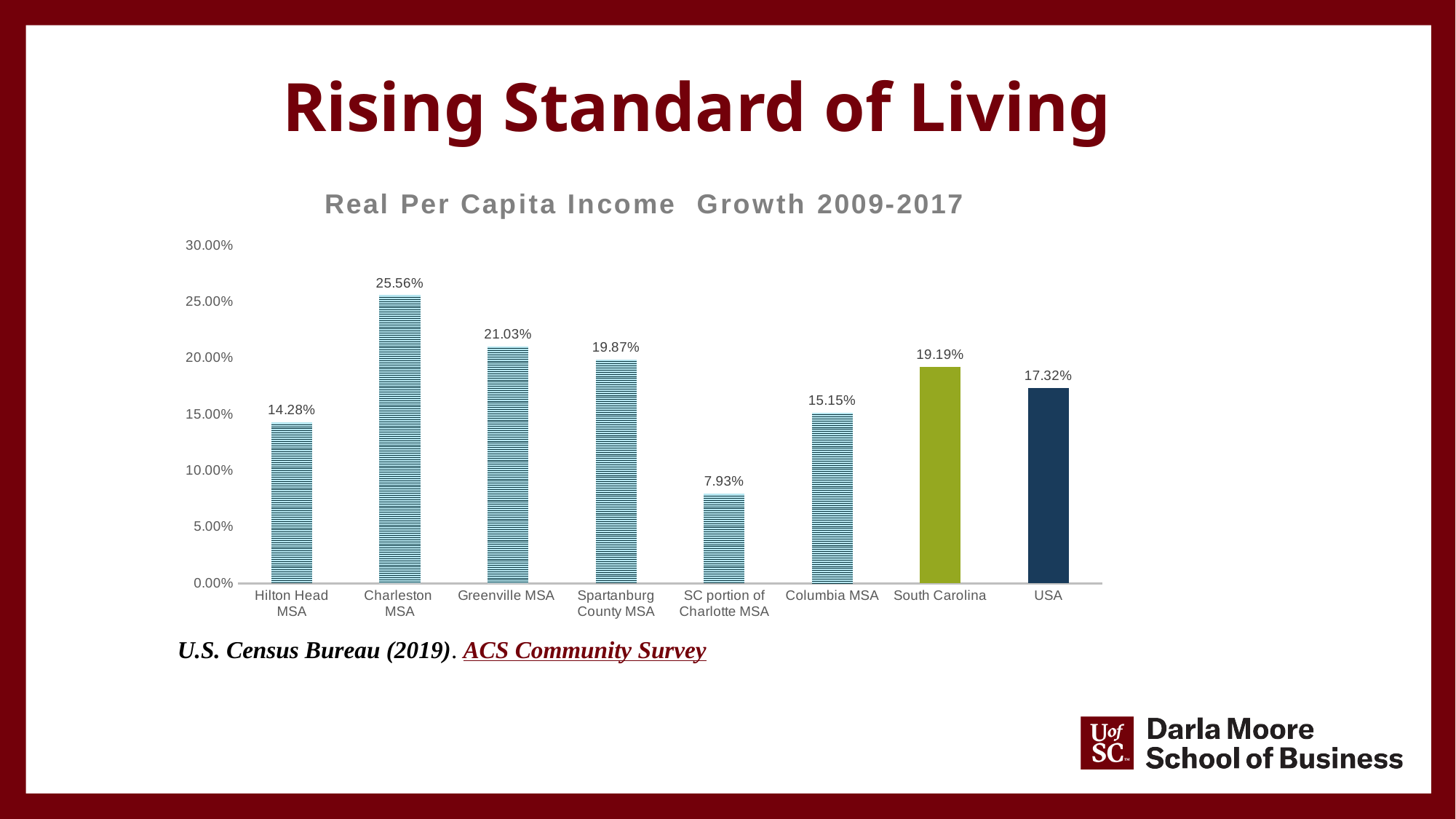
What is the value shown for the USA? 17.32% Which is larger, the value for Greenville MSA or the value for Columbia MSA? Greenville MSA Which category has the highest real per capita income growth? Charleston MSA How many categories are shown on the x axis? 8 What kind of chart is shown on the slide? Bar chart What is the real per capita income growth for Charleston MSA? 25.56% Is the value for Spartanburg County MSA greater or less than 20.00%? less What is the value shown for South Carolina? 19.19% What is the difference between the values for South Carolina and the USA? 1.87% What is the difference between the values for Charleston MSA and Hilton Head MSA? 11.28% Which category has the lowest real per capita income growth? SC portion of Charlotte MSA What is the title of the chart? Real Per Capita Income Growth 2009-2017